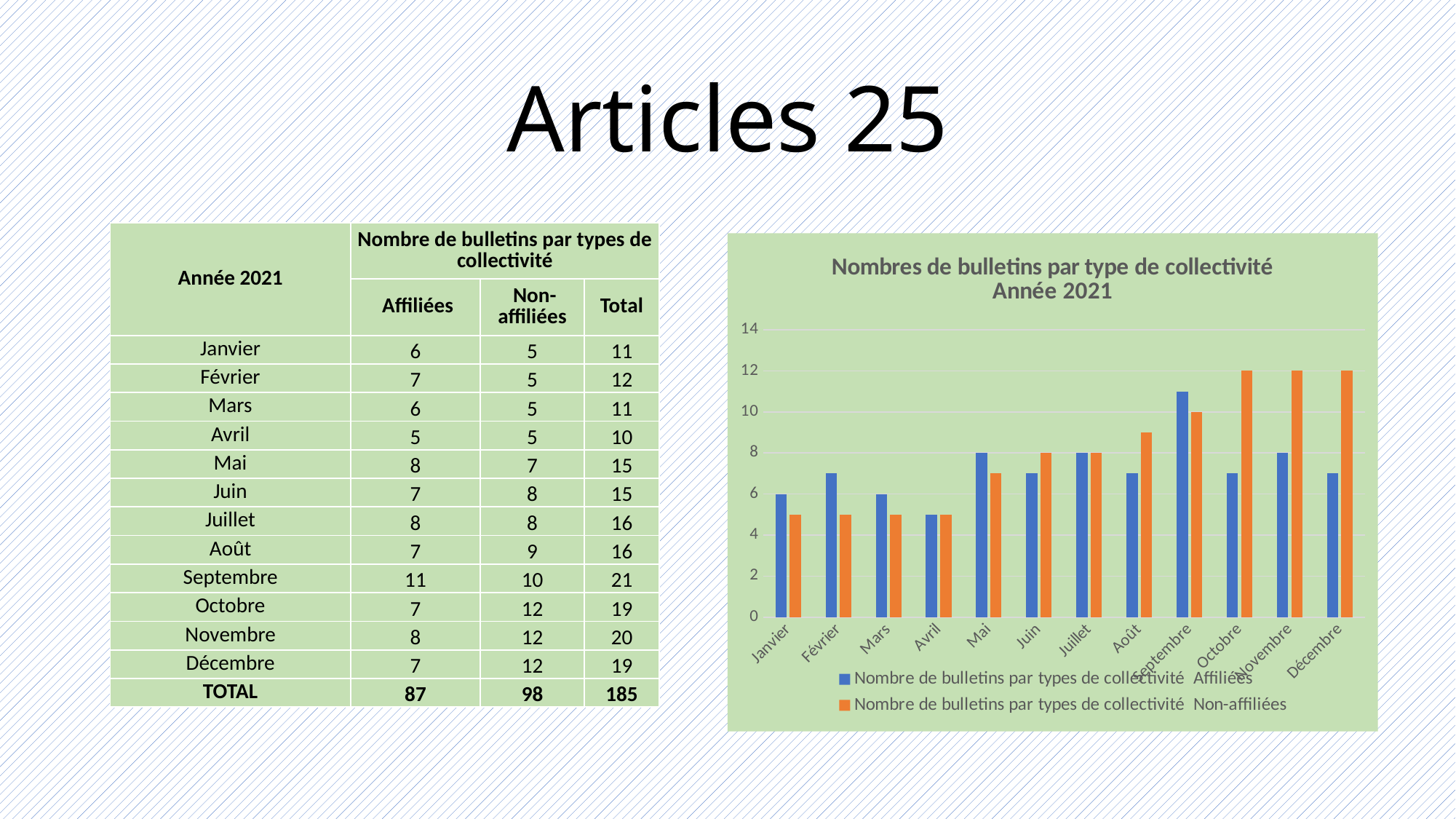
What type of chart is shown on the slide? bar chart How many months are shown on the x axis of the chart? 12 Which month has the highest value for Affiliées? Septembre Which is larger in Décembre, Affiliées or Non-affiliées? Non-affiliées What is the value for Affiliées in Janvier? 6 What is the value for Affiliées in Septembre? 11 Is the value for Non-affiliées in Novembre greater or less than 10? greater Which month has the lowest value for Affiliées? Avril What is the title of the chart? Nombres de bulletins par type de collectivité Année 2021 How many series does the chart legend list? 2 What is the value for Non-affiliées in Octobre? 12 What is the difference between Non-affiliées and Affiliées in Octobre? 5